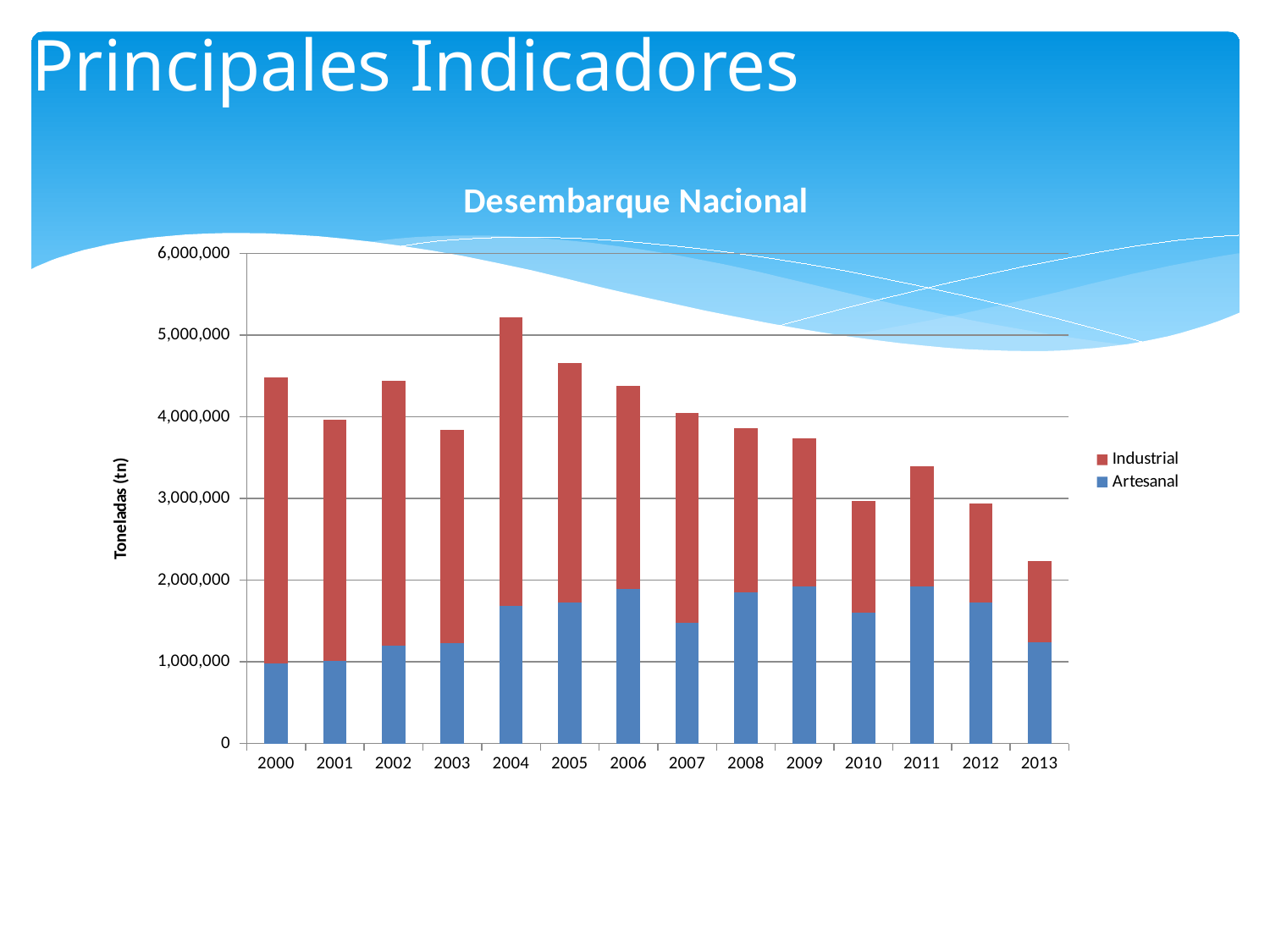
Which year has the lowest total bar? 2013 Which year has the larger total bar, 2011 or 2012? 2011 What is the title of the chart? Desembarque Nacional Is the total value for 2004 greater or less than 5,000,000? greater What kind of chart is shown on the slide? Stacked bar chart Is the total value for 2000 greater or less than 4,000,000? greater How many series does the legend list? 2 Which year has the highest total bar? 2004 Is the Artesanal value for 2009 greater or less than 1,000,000? greater Do the total values generally rise or fall from 2004 to 2013? fall How many years are shown on the x axis? 14